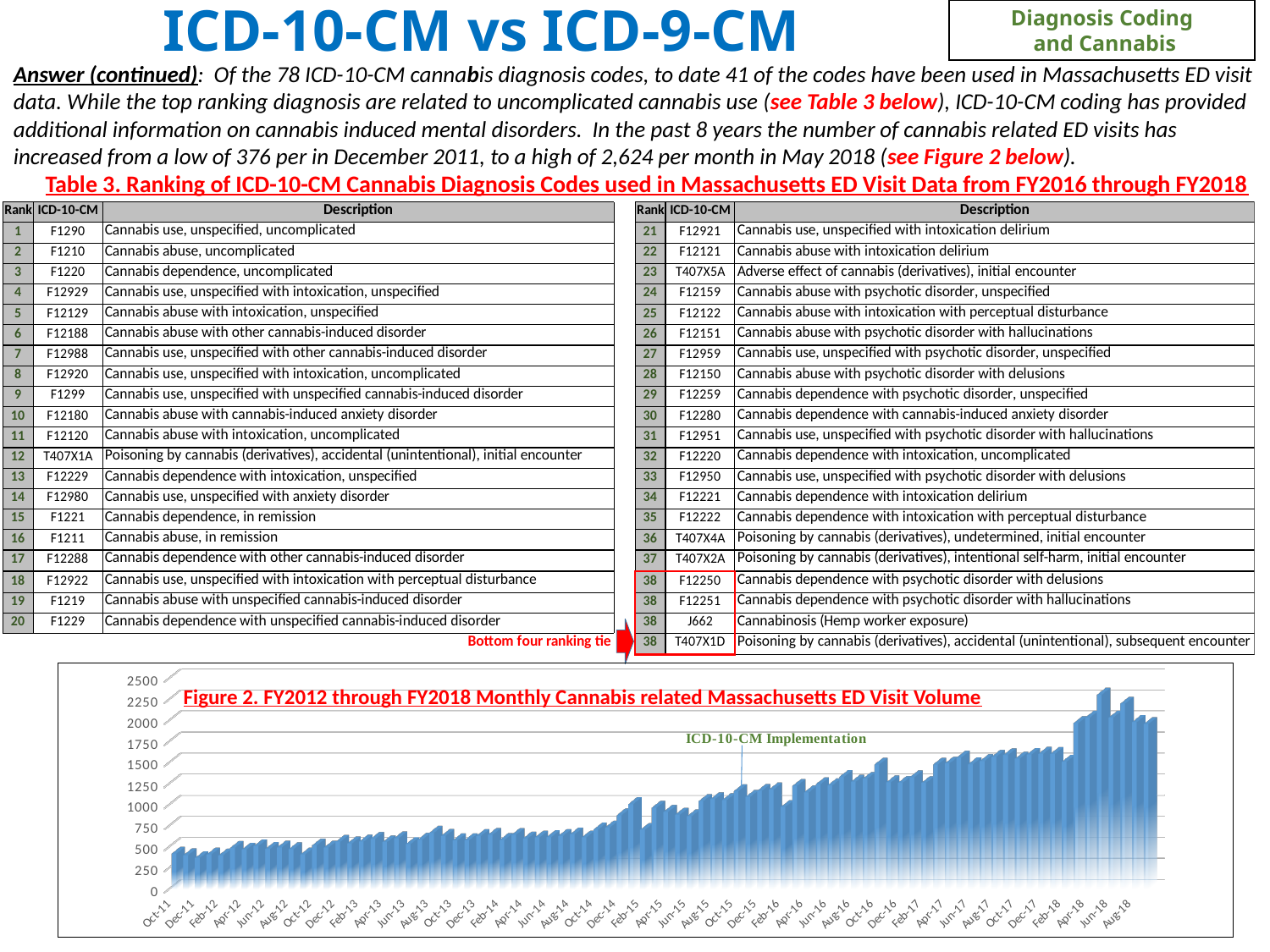
What is the title of the chart at the bottom of the slide? Figure 2. FY2012 through FY2018 Monthly Cannabis related Massachusetts ED Visit Volume In Figure 2, what event is annotated on the chart around Oct-15? ICD-10-CM Implementation In Figure 2, do the monthly ED visit values generally rise or fall from Oct-11 to Aug-18? rise In Figure 2, is the value for Dec-11 greater or less than 500? less What kind of chart is Figure 2? bar chart In Figure 2, which is larger, the value for Aug-18 or the value for Aug-12? Aug-18 What is the highest tick value shown on the vertical axis of Figure 2? 2500 In Figure 2, is the value for Oct-11 greater or less than 1000? less In Figure 2, which month has the highest cannabis related ED visit volume? May-18 In Figure 2, is the value for Aug-18 greater or less than 1750? greater